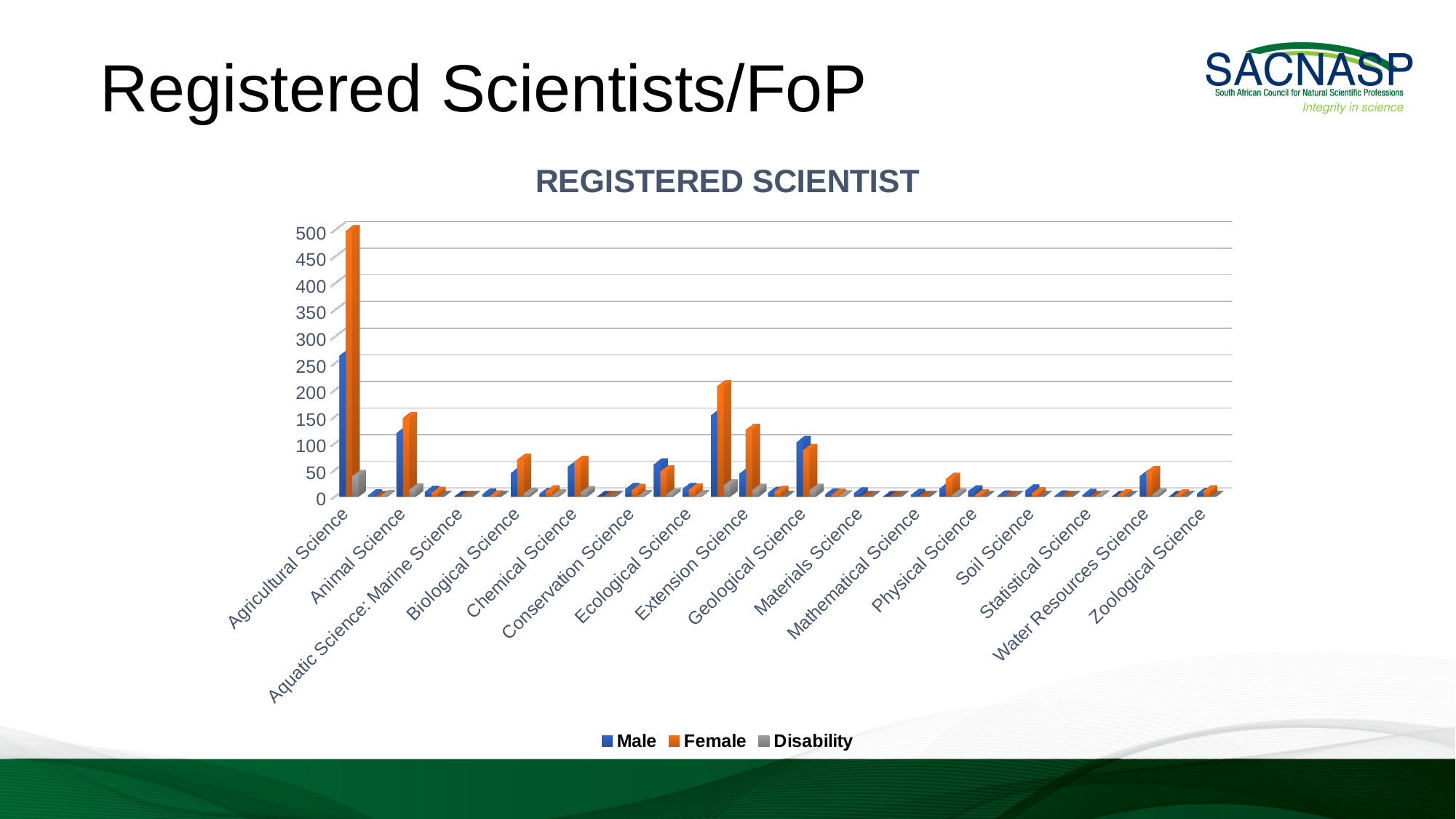
What kind of chart is shown on the slide? Bar chart For Agricultural Science, which is larger, the Male value or the Female value? Female How many series does the legend list? 3 Is the Female value for Agricultural Science greater or less than 400? greater Is the Female value for Biological Science greater or less than 50? greater Which category has the highest Female value? Agricultural Science Is the Male value for Agricultural Science greater or less than 200? greater For Extension Science, which is larger, the Male value or the Female value? Female What is the title of the chart? REGISTERED SCIENTIST Which category has the highest Male value? Agricultural Science